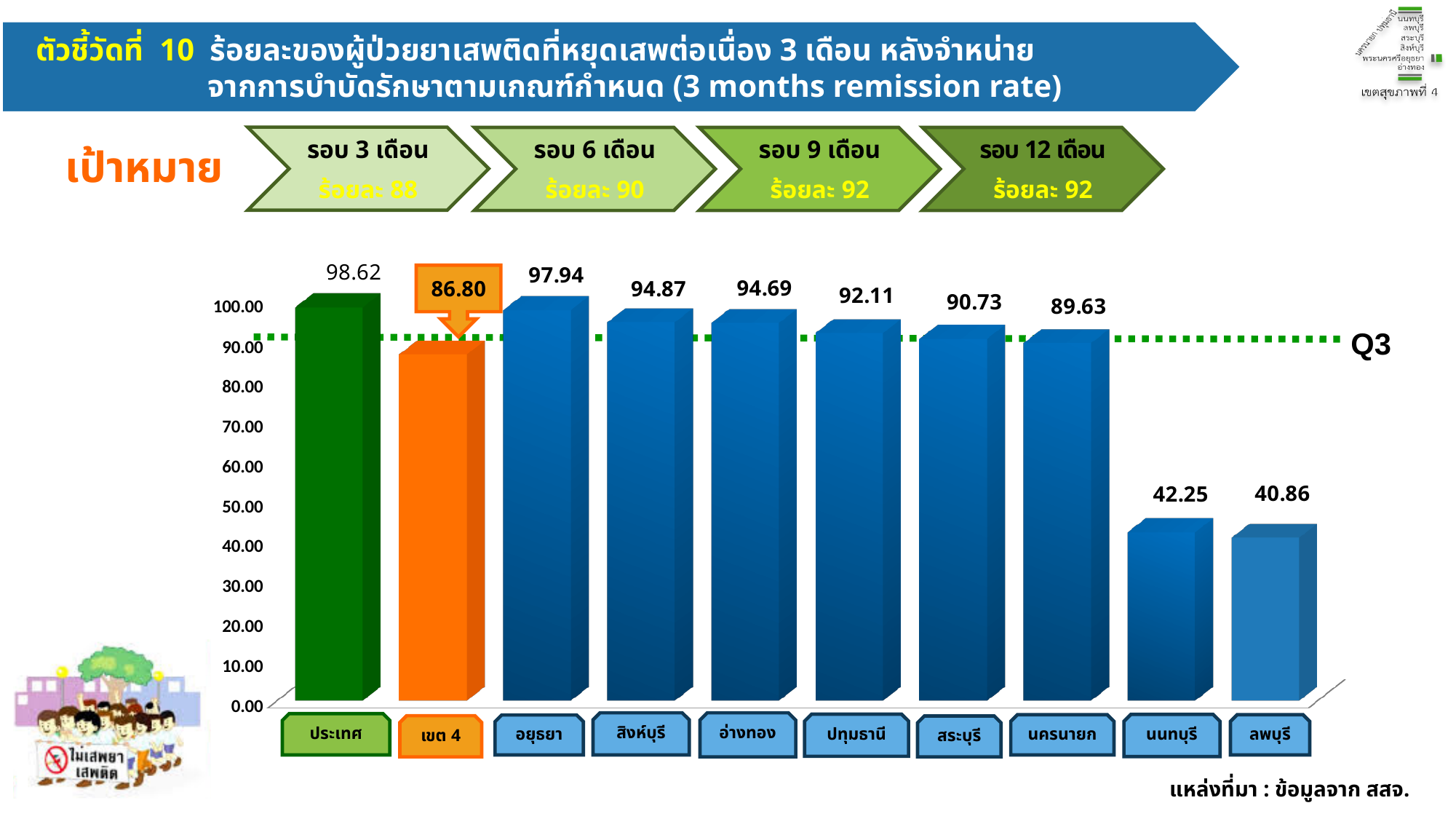
Which is larger, the value for สิงห์บุรี or the value for อ่างทอง? สิงห์บุรี What kind of chart is shown on the slide? bar chart What is the value for เขต 4? 86.80 How many categories are shown on the x axis? 10 What is the value for ประเทศ? 98.62 Which category has the lowest value? ลพบุรี What is the value for ลพบุรี? 40.86 What is the difference between the values for อยุธยา and เขต 4? 11.14 Is the value for นนทบุรี greater or less than 50.00? less What label is shown at the right end of the dotted green horizontal line? Q3 What is the value for นครนายก? 89.63 Which category has the highest value? ประเทศ